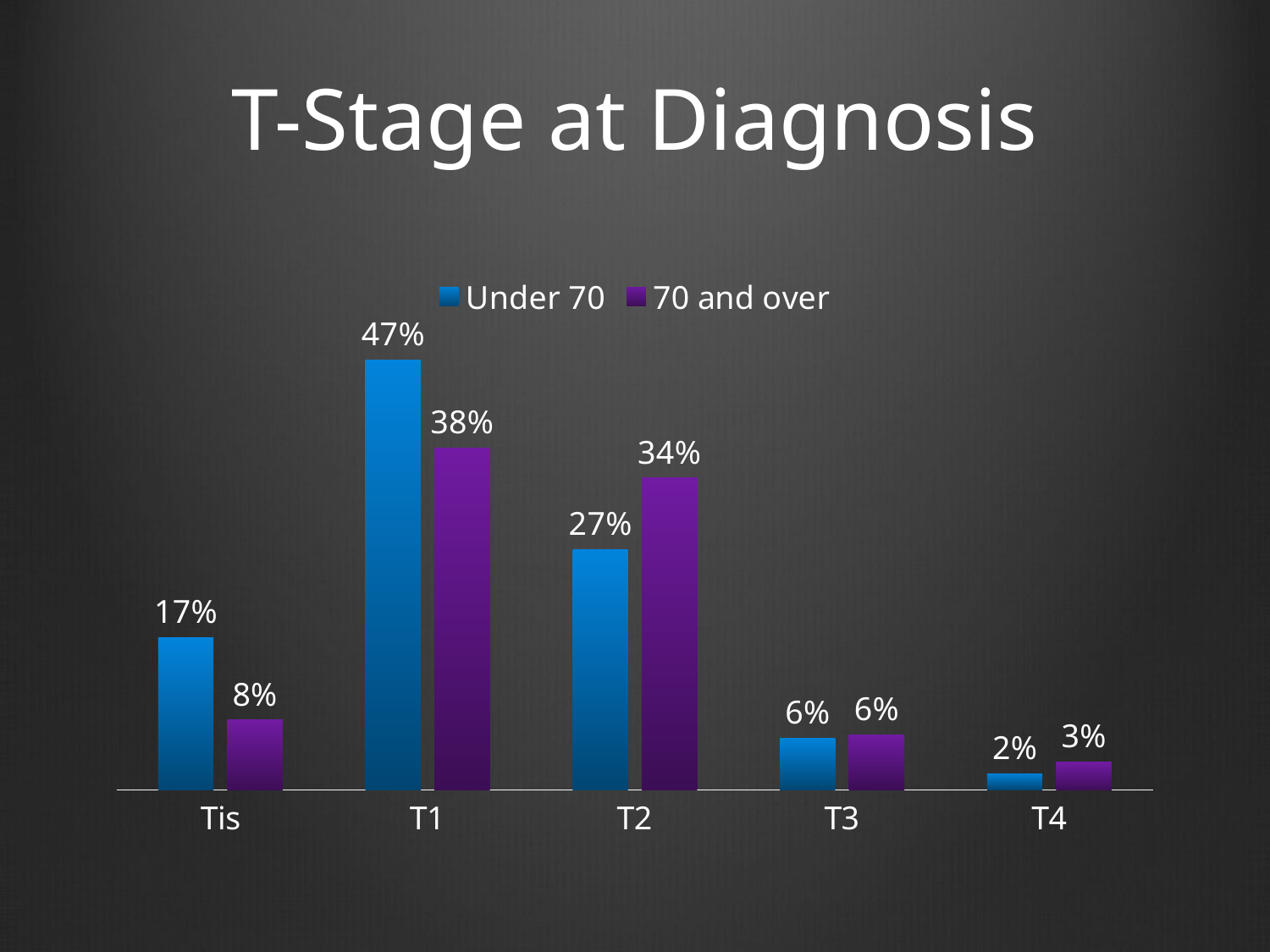
What is the value for 70 and over at T2? 34% What is the value for Under 70 at T4? 2% At T2, which series has the larger value, Under 70 or 70 and over? 70 and over What kind of chart is shown on the slide? Bar chart Which T-stage has the lowest value for the 70 and over series? T4 What is the value for Under 70 at T1? 47% What is the difference between the Under 70 and 70 and over values at T1? 9% What is the title of the chart? T-Stage at Diagnosis What is the value for 70 and over at Tis? 8% How many series does the legend list? 2 How many T-stage categories are shown on the x axis? 5 Which T-stage has the highest value for the Under 70 series? T1